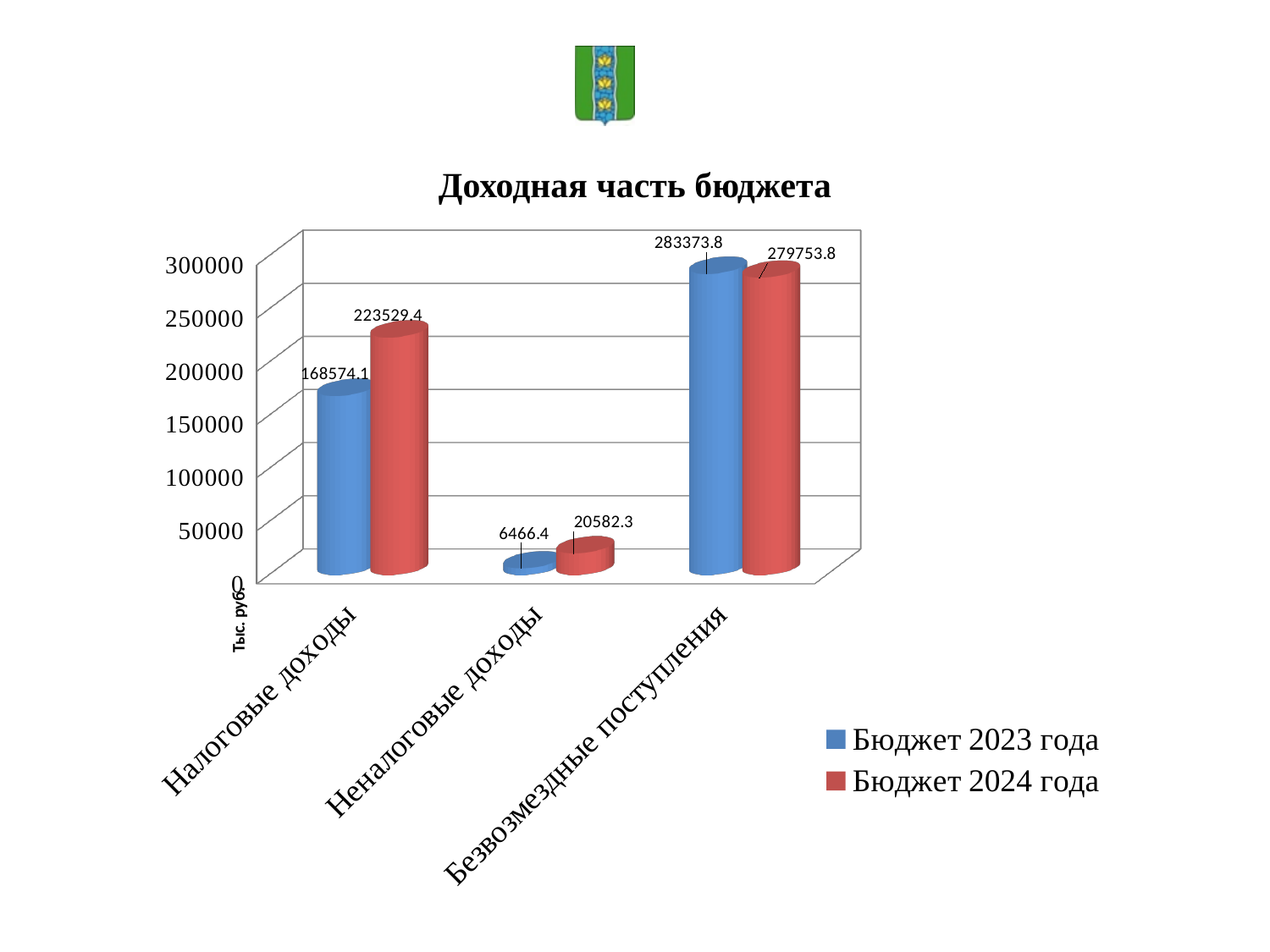
What is the difference between the Бюджет 2024 года and Бюджет 2023 года values for Налоговые доходы? 54955.3 How many series does the legend list? 2 For Неналоговые доходы, which series has the larger value, Бюджет 2023 года or Бюджет 2024 года? Бюджет 2024 года Which category has the lowest value in the Бюджет 2023 года series? Неналоговые доходы Which category has the highest value in the Бюджет 2024 года series? Безвозмездные поступления What is the value for Неналоговые доходы in the Бюджет 2024 года series? 20582.3 What is the value for Налоговые доходы in the Бюджет 2024 года series? 223529.4 What is the value for Безвозмездные поступления in the Бюджет 2023 года series? 283373.8 What is the value for Налоговые доходы in the Бюджет 2023 года series? 168574.1 What is the title of the chart? Доходная часть бюджета What is the difference between the Бюджет 2023 года and Бюджет 2024 года values for Безвозмездные поступления? 3620.0 How many categories are shown on the x axis? 3